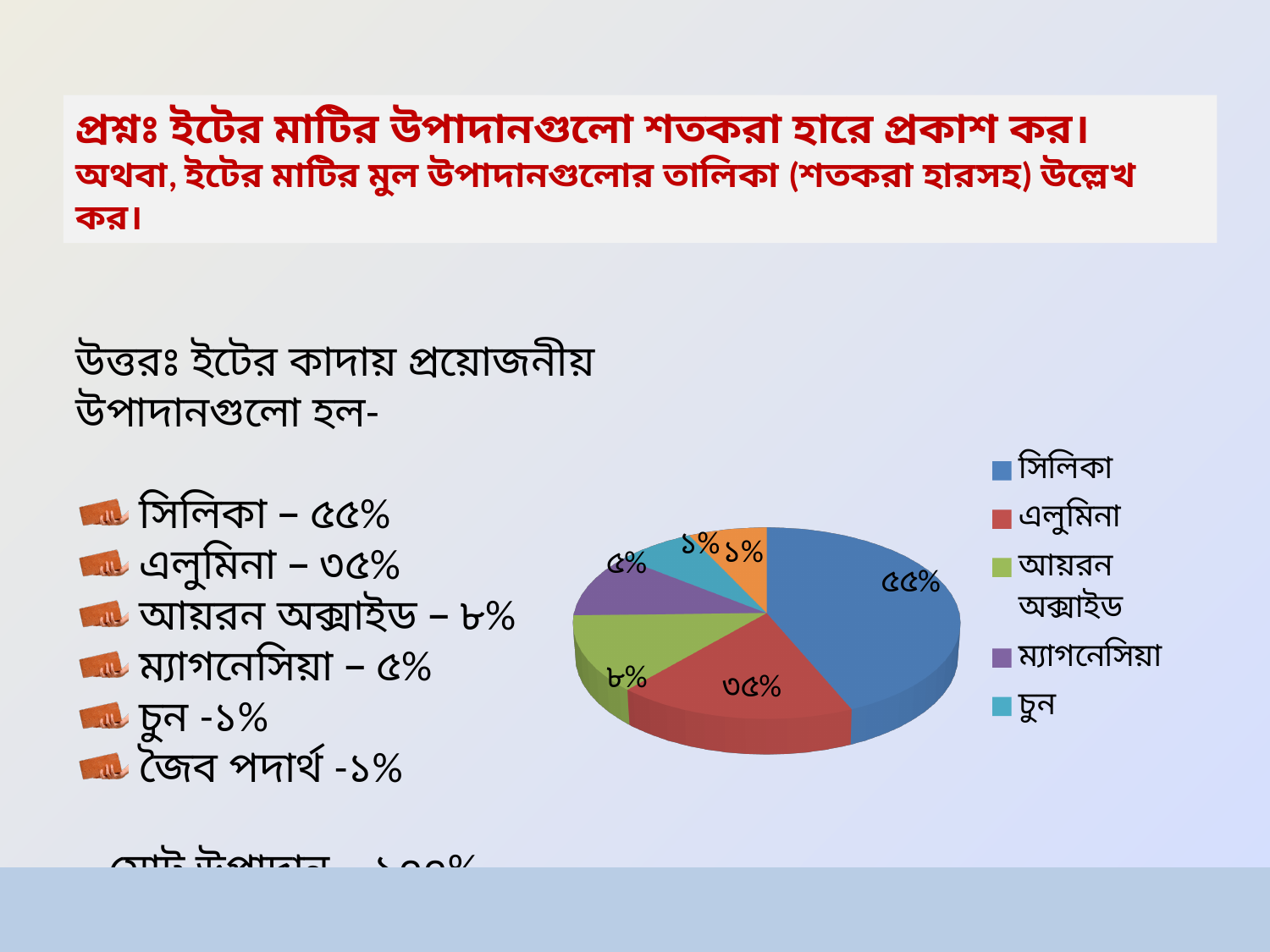
What colour is the সিলিকা slice in the pie chart? blue Which slice is larger in the pie chart, এলুমিনা or আয়রন অক্সাইড? এলুমিনা What percentage does the আয়রন অক্সাইড slice show in the pie chart? ৮% What percentage does the চুন slice show in the pie chart? ১% How many entries does the pie chart's legend list? 5 How many slices does the pie chart have? 6 Which component has the largest slice in the pie chart? সিলিকা What percentage does the ম্যাগনেসিয়া slice show in the pie chart? ৫% What percentage does the সিলিকা slice show in the pie chart? ৫৫% What is the difference between the সিলিকা slice and the এলুমিনা slice in the pie chart? ২০% What kind of chart is shown on the slide? pie chart What percentage does the এলুমিনা slice show in the pie chart? ৩৫%